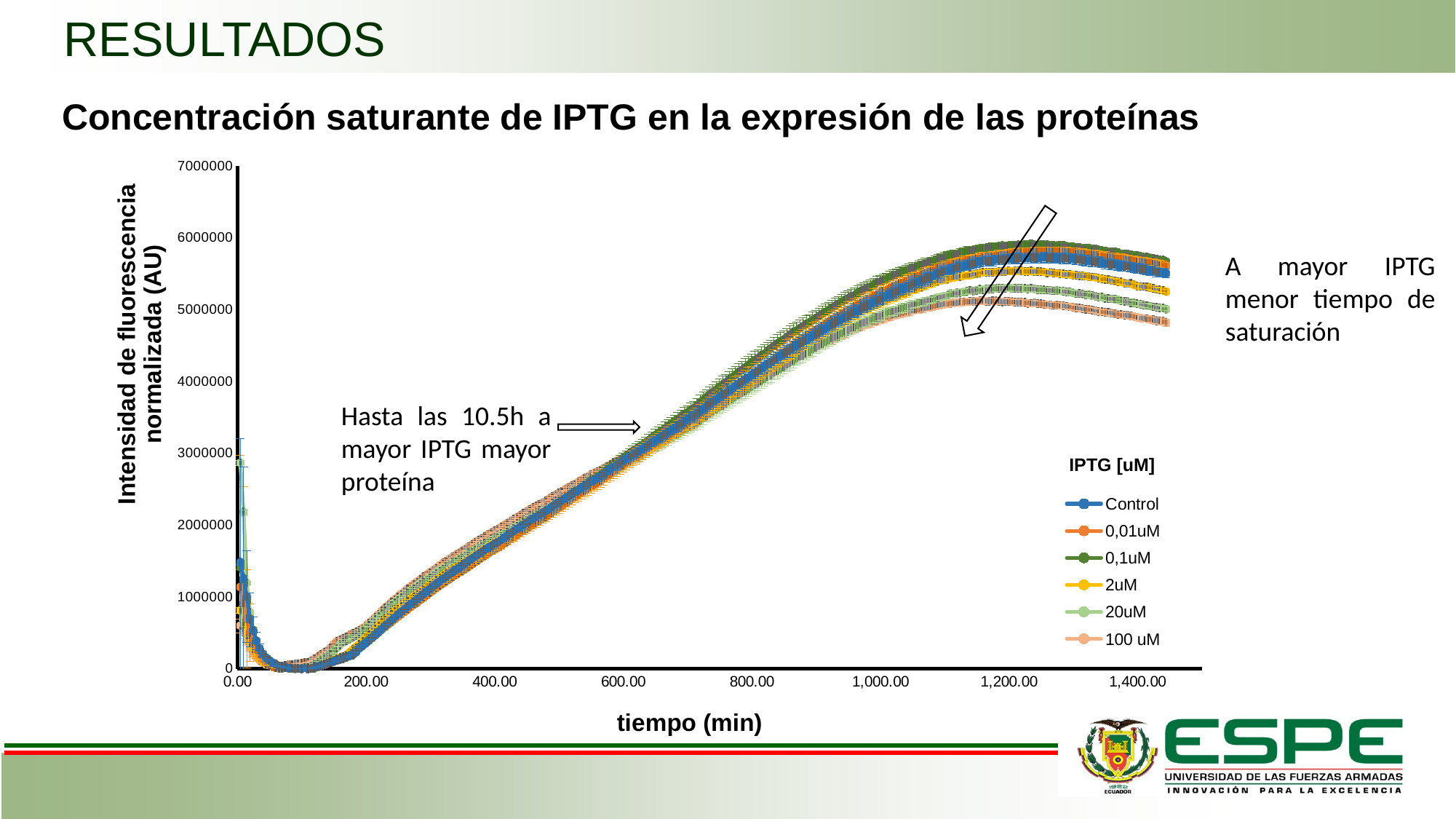
At 1,400.00 min, which is larger: the Control series or the 100 uM series? Control Do the values rise or fall along the x axis between 200.00 and 1,000.00 min? rise How many series does the legend list? 6 Is the value of the 100 uM series at 600.00 min greater or less than 2000000? greater Is the value of the Control series at 200.00 min greater or less than 1000000? less Is the value of the Control series at 1,000.00 min greater or less than 4000000? greater What kind of chart is shown on the slide? line chart What is the title of the legend? IPTG [uM] What is the label of the y axis? Intensidad de fluorescencia normalizada (AU) At 1,400.00 min, which is larger: the 0,1uM series or the 100 uM series? 0,1uM